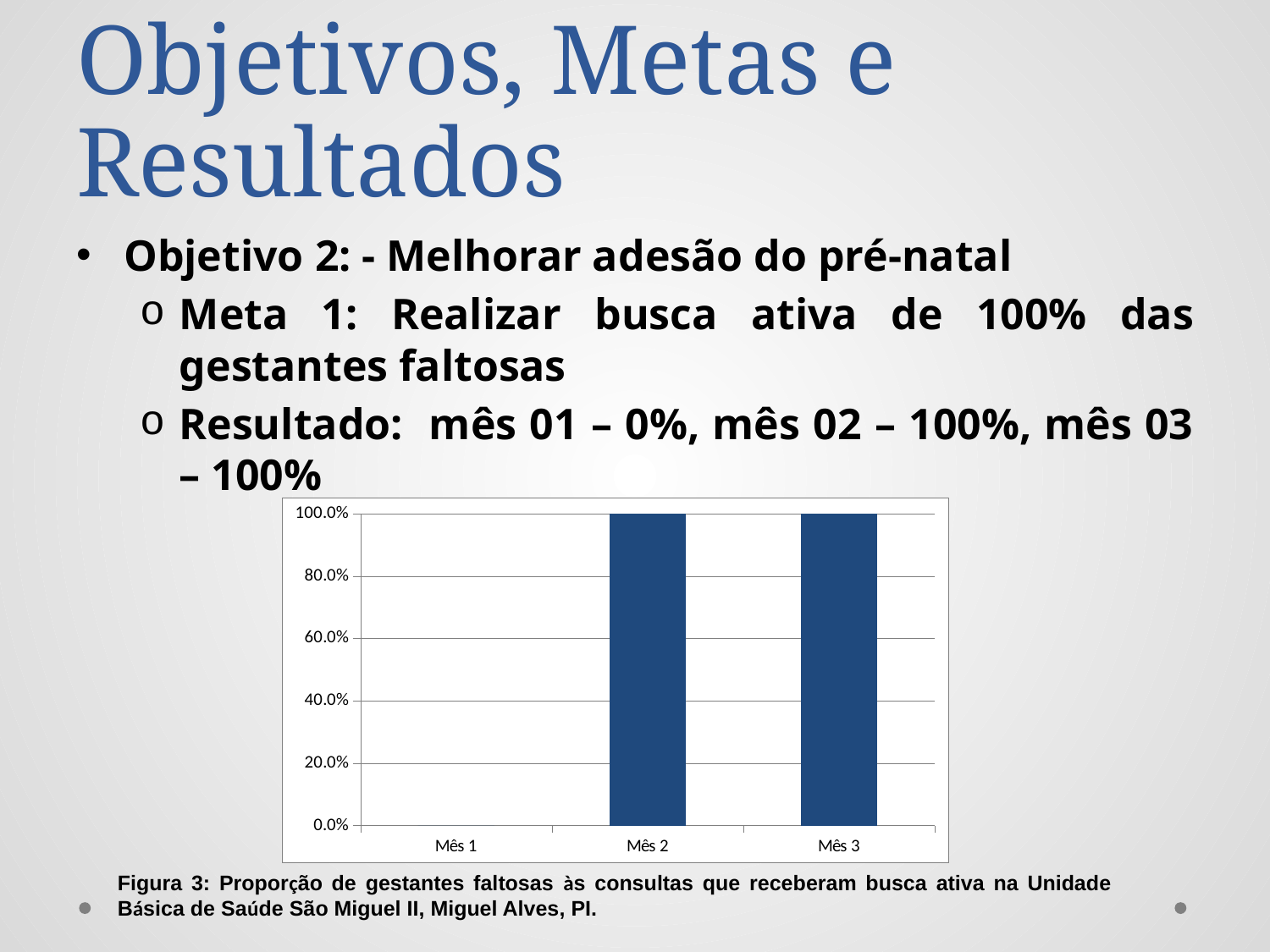
What is the value for Mês 2 in the chart? 100.0% Which month has the lowest value in the chart? Mês 1 What is the difference between the value for Mês 2 and the value for Mês 1? 100.0% What kind of chart is shown on the slide? bar chart What is the value for Mês 1 in the chart? 0.0% What is the figure number given in the caption below the chart? Figura 3 Do the values rise or fall from Mês 1 to Mês 3 in the chart? rise Which is larger in the chart, the value for Mês 1 or the value for Mês 2? Mês 2 How many categories are shown on the x axis of the chart? 3 Is the value for Mês 3 greater or less than 60.0%? greater What colour are the bars in the chart? blue What is the value for Mês 3 in the chart? 100.0%